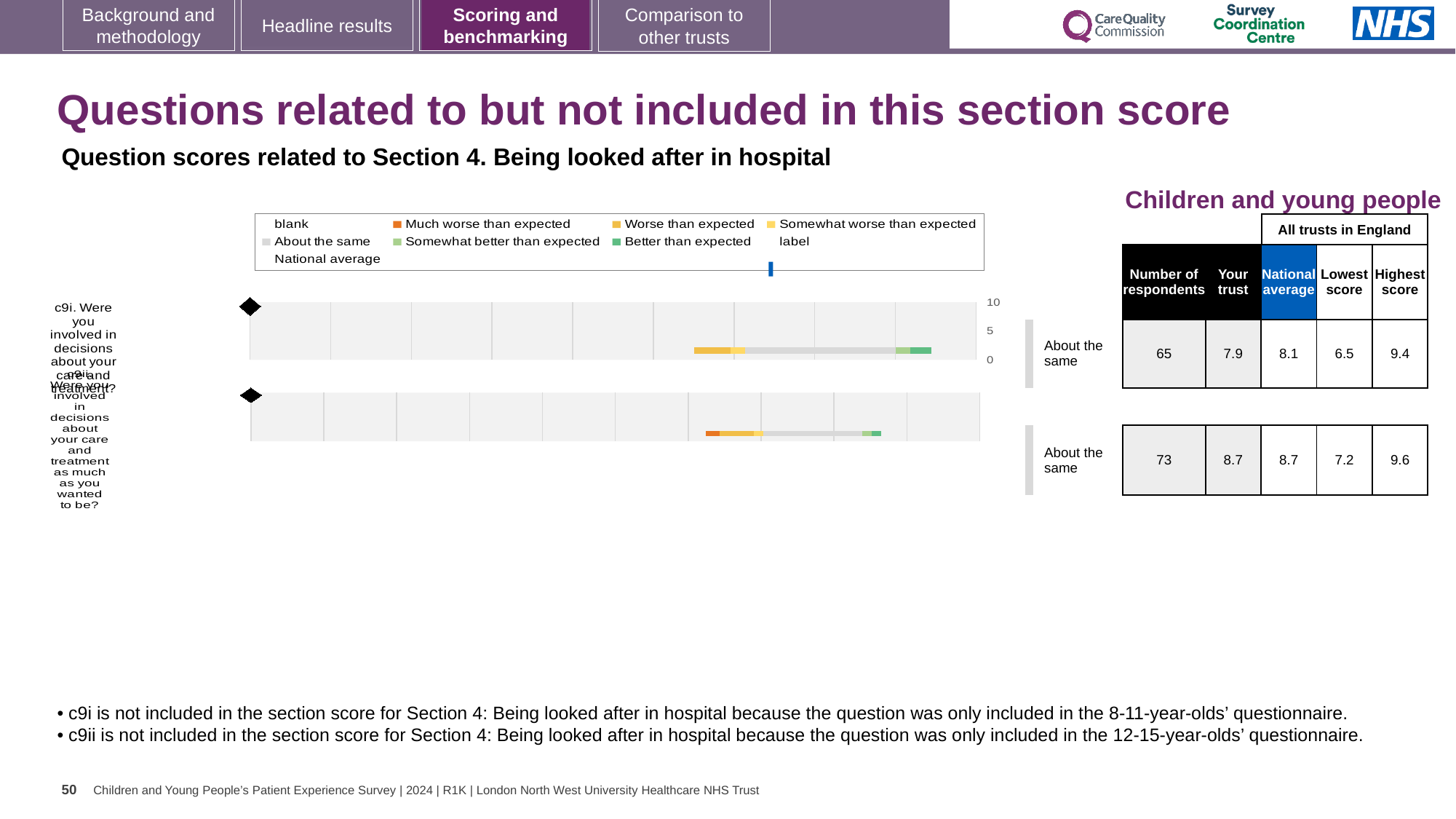
What benchmark label is given next to the bar for question c9i? About the same What kind of chart is used to show the benchmark bands for questions c9i and c9ii? bar chart Which legend entry is shown in orange? Much worse than expected What is the maximum value shown on the chart's score axis? 10 According to the table, what is the highest score across all trusts in England for question c9ii? 9.6 According to the table, what is the 'Your trust' score for question c9i? 7.9 According to the table, how many respondents answered question c9ii? 73 Which question has the higher 'Your trust' score in the table, c9i or c9ii? c9ii According to the table, what is the national average for question c9i? 8.1 How many questions (c9i and c9ii) are plotted as bars on the slide? 2 According to the table, what is the 'Your trust' score for question c9ii? 8.7 What is the difference between the highest score (9.4) and the lowest score (6.5) for question c9i in the table? 2.9